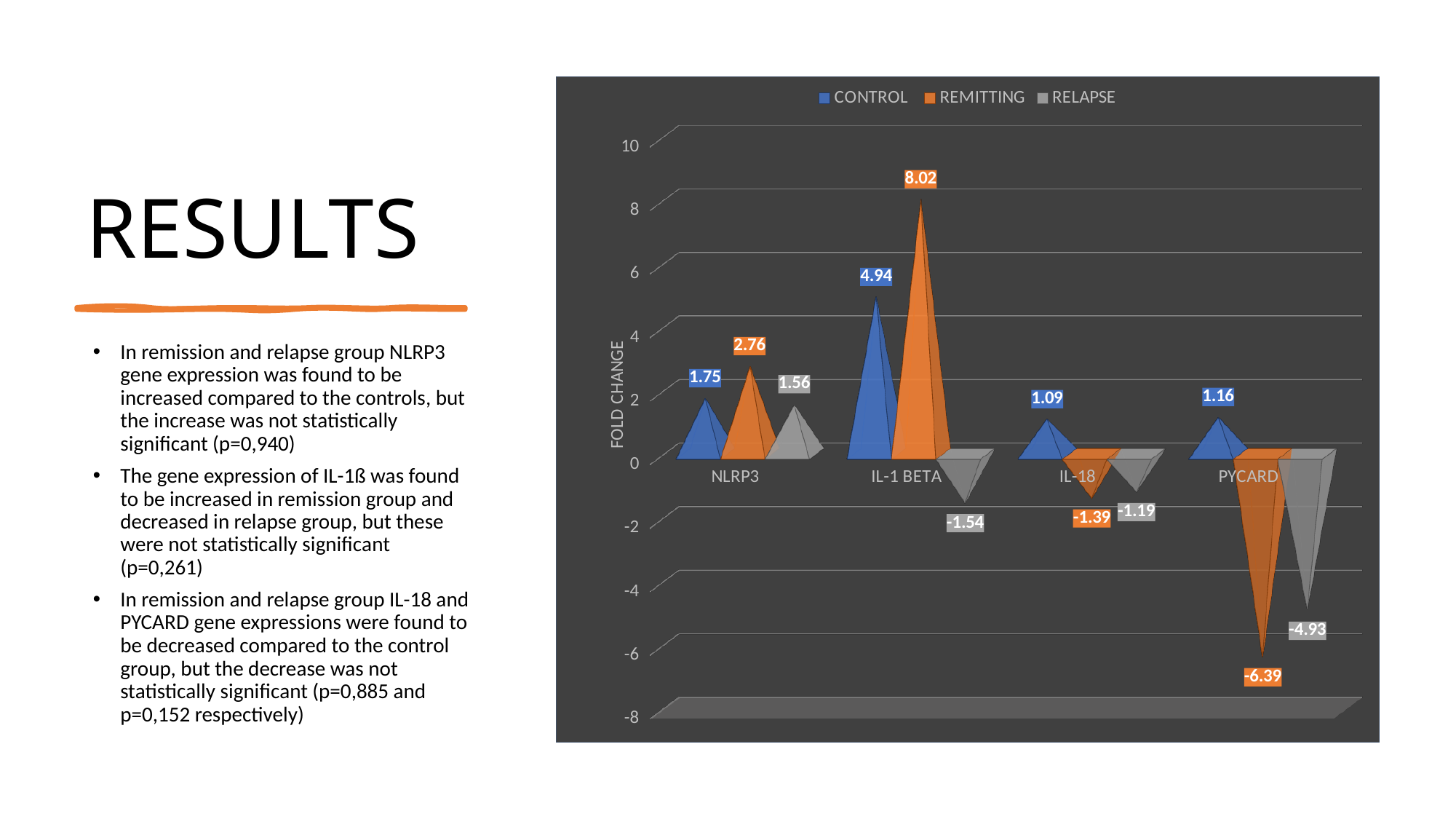
How many series does the legend list? 3 What is the REMITTING value for IL-1 BETA? 8.02 Which gene has the highest REMITTING value? IL-1 BETA What is the RELAPSE value for PYCARD? -4.93 Which gene has the lowest REMITTING value? PYCARD What is the difference between the REMITTING and CONTROL values for IL-1 BETA? 3.08 What is the CONTROL value for NLRP3? 1.75 What is the label of the vertical axis? FOLD CHANGE Which is larger for NLRP3, the CONTROL value or the RELAPSE value? CONTROL How many genes are shown on the x axis? 4 What kind of chart is shown? bar chart What is the REMITTING value for IL-18? -1.39